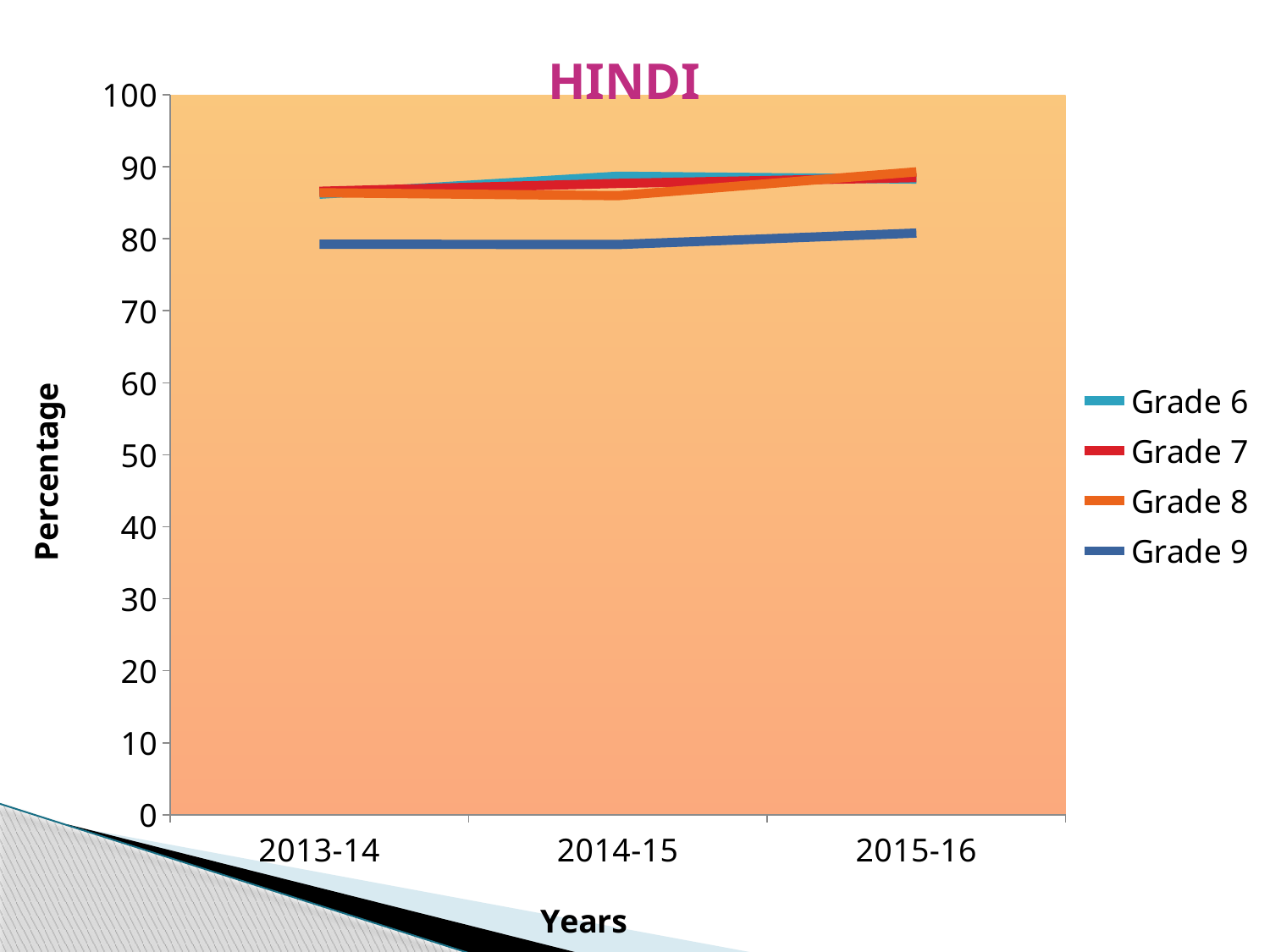
How many years are shown on the x axis? 3 What is the title of the chart? HINDI What is the label of the vertical axis? Percentage Does the value for Grade 9 rise or fall from 2014-15 to 2015-16? rise What kind of chart is shown on the slide? line chart Is the value for Grade 9 in 2013-14 greater or less than 70? greater Which grade has the lowest value in 2013-14? Grade 9 Is the value for Grade 9 in 2014-15 greater or less than 90? less Which is larger in 2015-16, the value for Grade 8 or the value for Grade 9? Grade 8 Which grade has the lowest value in 2015-16? Grade 9 Is the value for Grade 6 in 2014-15 greater or less than 80? greater How many series does the legend list? 4